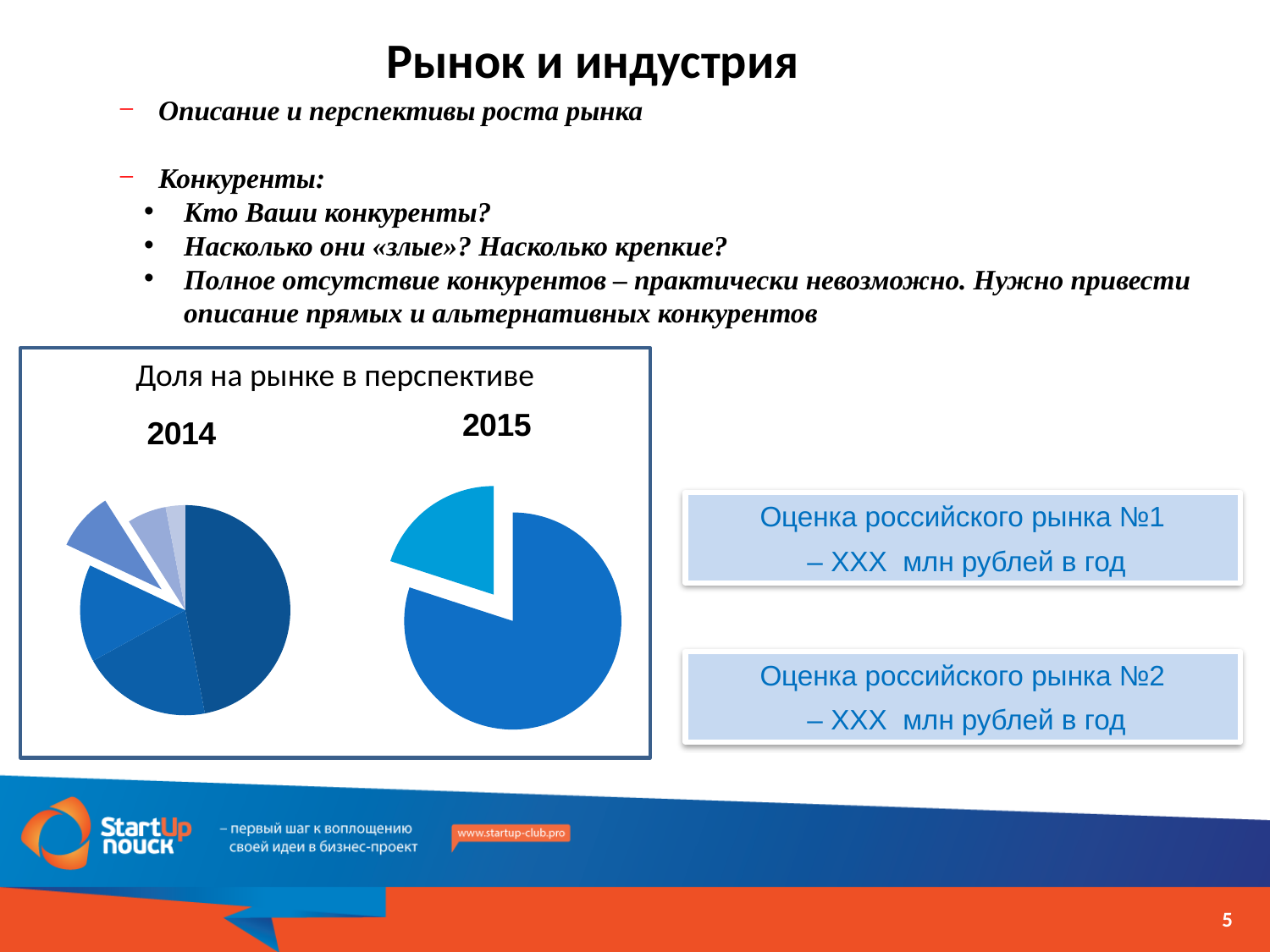
How many slices does the 2015 pie chart have? 2 In the 2015 pie chart, is the dark blue slice larger or smaller than the light blue slice? Larger How many pie charts are shown on the slide? 2 In the 2015 pie chart, is the light blue slice greater or less than half of the pie? less Which pie chart has more slices, 2014 or 2015? 2014 What is the title of the chart box containing the two pie charts? Доля на рынке в перспективе Which years are shown above the two pie charts? 2014 and 2015 What kind of chart is used to show the market share for 2014 and 2015? Pie chart